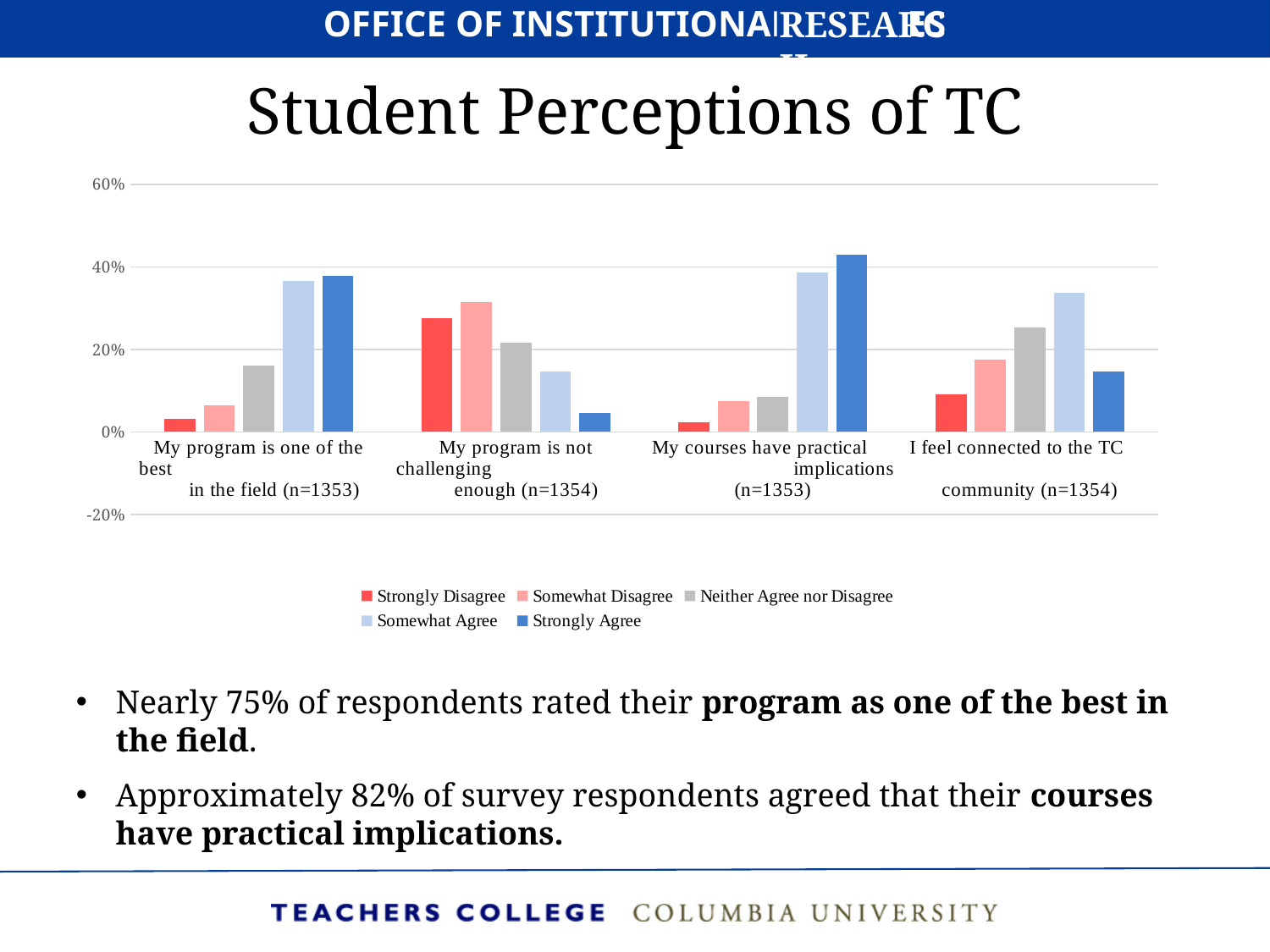
Which statement has the highest Strongly Disagree value? My program is not challenging enough (n=1354) Is the Somewhat Agree value for "I feel connected to the TC community (n=1354)" greater or less than 40%? less Which has the larger Strongly Agree value: "My program is one of the best in the field" or "I feel connected to the TC community"? My program is one of the best in the field How many survey statements (categories) are shown on the x axis? 4 What kind of chart is shown on the slide? bar chart Which statement has the lowest Strongly Agree value? My program is not challenging enough (n=1354) Which statement has the highest Strongly Agree value? My courses have practical implications (n=1353) Is the Strongly Agree value for "My courses have practical implications (n=1353)" greater or less than 40%? greater Is the Strongly Disagree value for "My program is not challenging enough (n=1354)" greater or less than 20%? greater What is the title of the chart? Student Perceptions of TC How many series does the legend list? 5